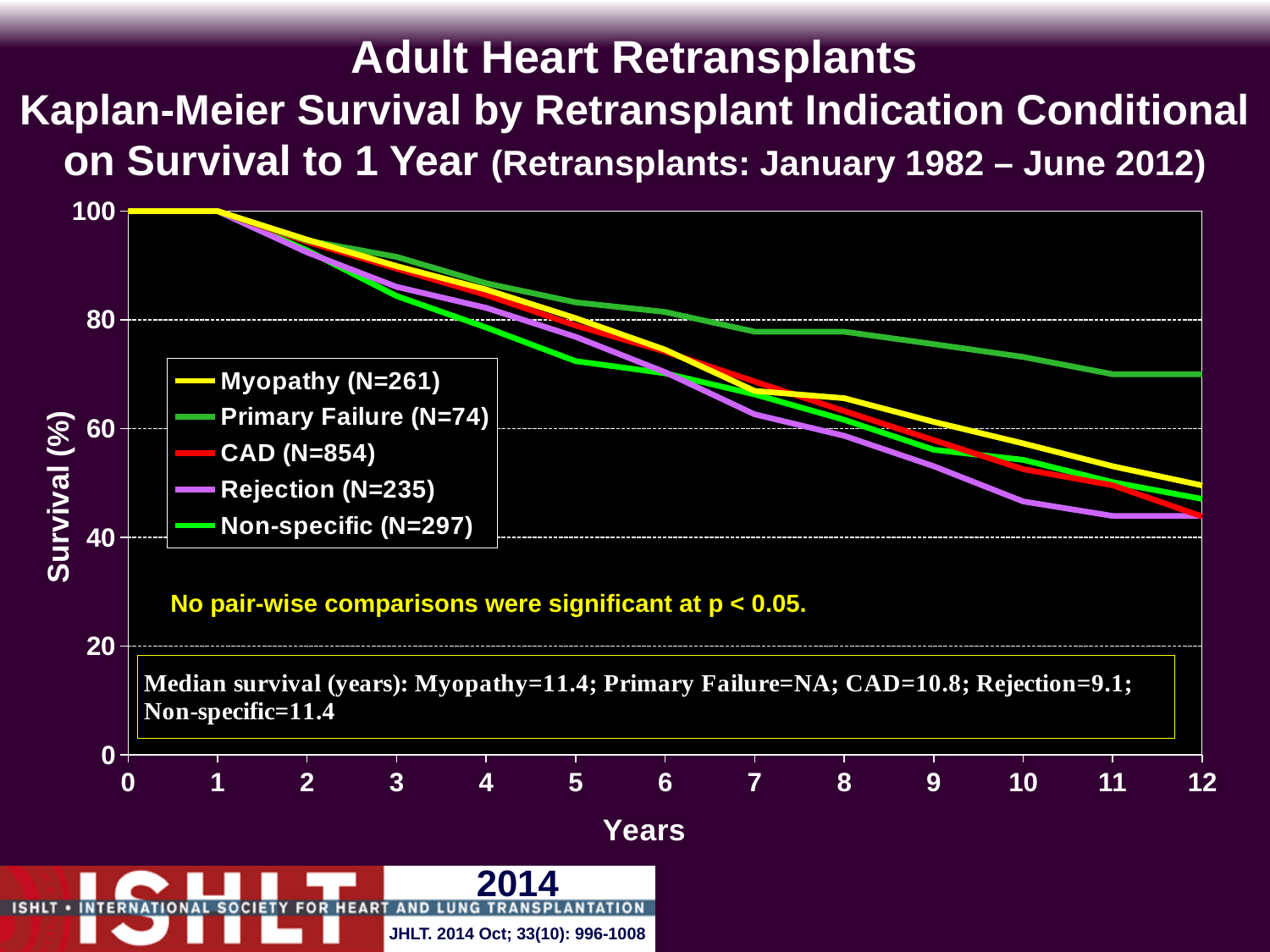
What is the difference between the median survival of Myopathy and Rejection, in years? 2.3 How many series does the legend list? 5 What is the median survival in years for the Rejection group? 9.1 Is the survival for Rejection at 12 years greater or less than 60? less Which series has the lowest survival at 10 years? Rejection (N=235) Which series has the highest survival at 12 years? Primary Failure (N=74) Is the survival for Primary Failure at 12 years greater or less than 60? greater Do the survival curves rise or fall as years increase? Fall What is the N for the CAD series in the legend? 854 At 9 years, which has higher survival: Primary Failure or CAD? Primary Failure What kind of chart is shown on the slide? Line chart What is the median survival given for the Primary Failure group? NA